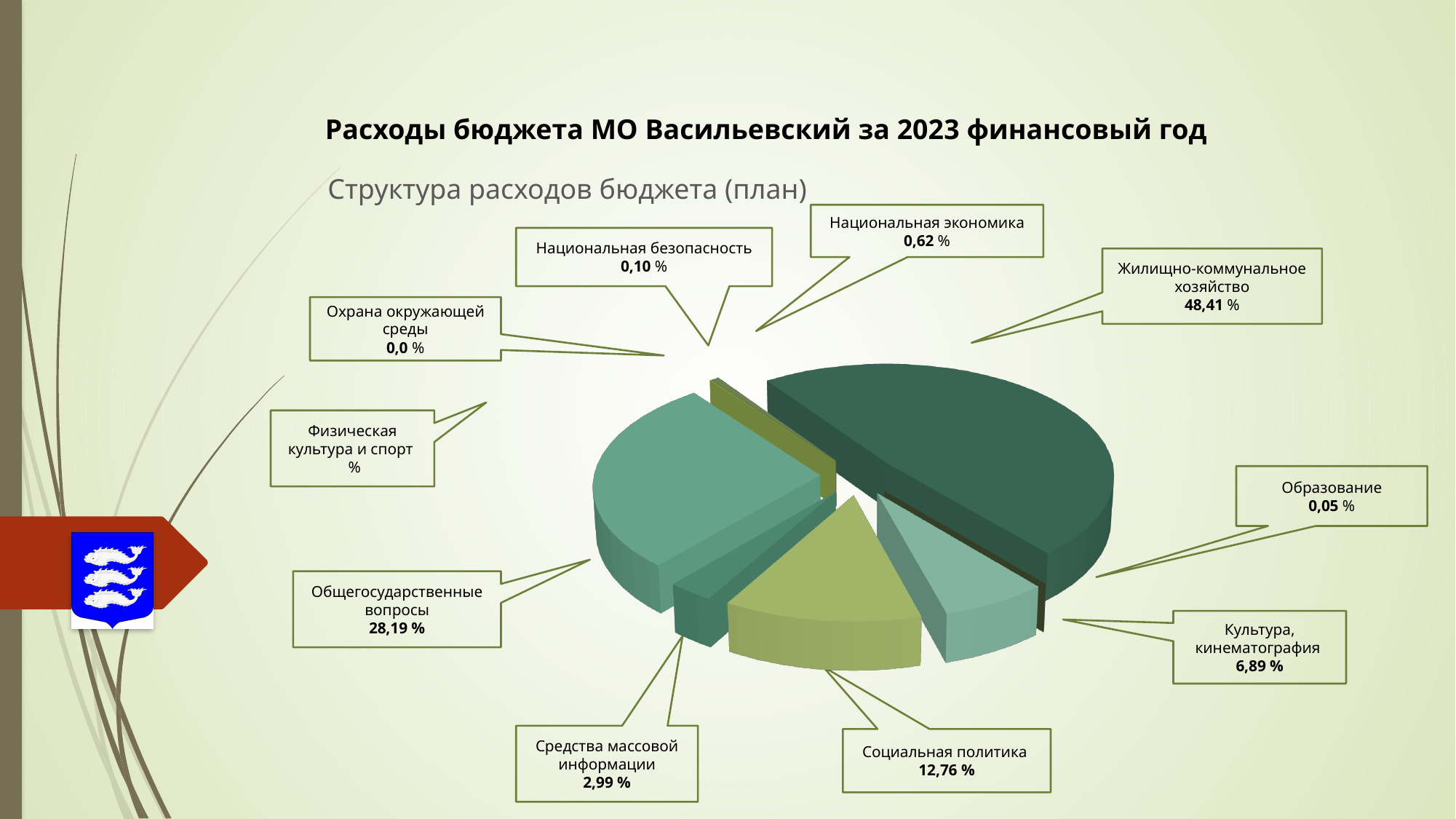
What kind of chart is shown on the slide? pie chart Which category has the largest share of the budget expenditure? Жилищно-коммунальное хозяйство What share of the budget expenditure is Социальная политика? 12,76 % What share of the budget expenditure is Культура, кинематография? 6,89 % What is the difference between the shares of Жилищно-коммунальное хозяйство and Общегосударственные вопросы? 20,22 % What share of the budget expenditure is Общегосударственные вопросы? 28,19 % What share of the budget expenditure is Национальная экономика? 0,62 % Which is larger: the share of Социальная политика or the share of Культура, кинематография? Социальная политика What is the subtitle of the chart on the slide? Структура расходов бюджета (план) What share of the budget expenditure is Средства массовой информации? 2,99 % What share of the budget expenditure is Жилищно-коммунальное хозяйство? 48,41 %